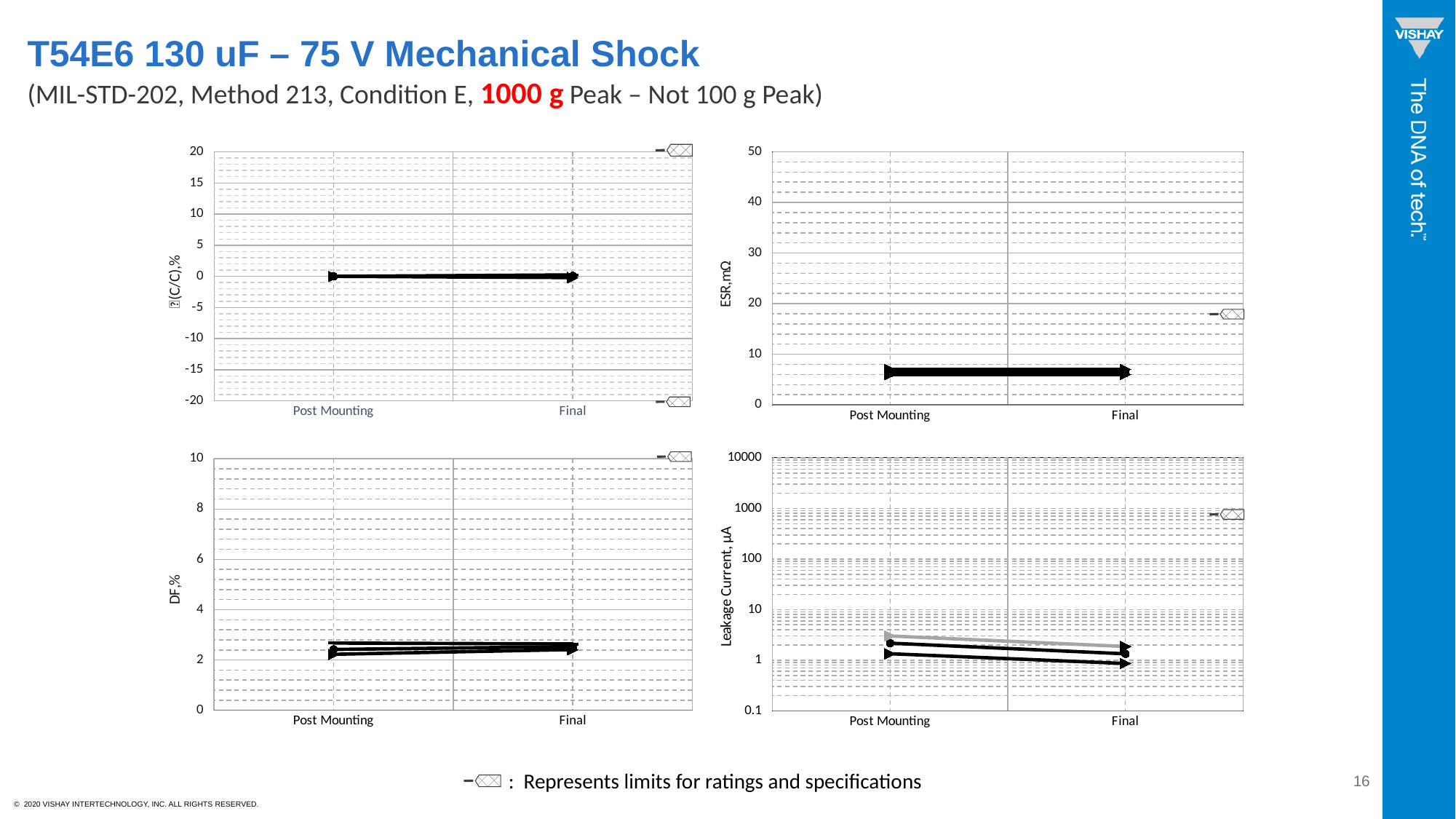
What kind of chart is the top-left chart (ΔC/C, %)? line chart In the bottom-right Leakage Current chart, is the highest value at Post Mounting greater or less than 10? less What is the y-axis label of the bottom-right chart? Leakage Current, µA In the bottom-right Leakage Current chart, do the values rise or fall from Post Mounting to Final? fall In the top-left ΔC/C chart, is the value at Post Mounting greater or less than -5? greater In the top-right ESR chart, is the value at Final greater or less than 5? greater How many x-axis categories does the top-right ESR chart show? 2 What are the two x-axis categories on the bottom-left DF chart? Post Mounting and Final